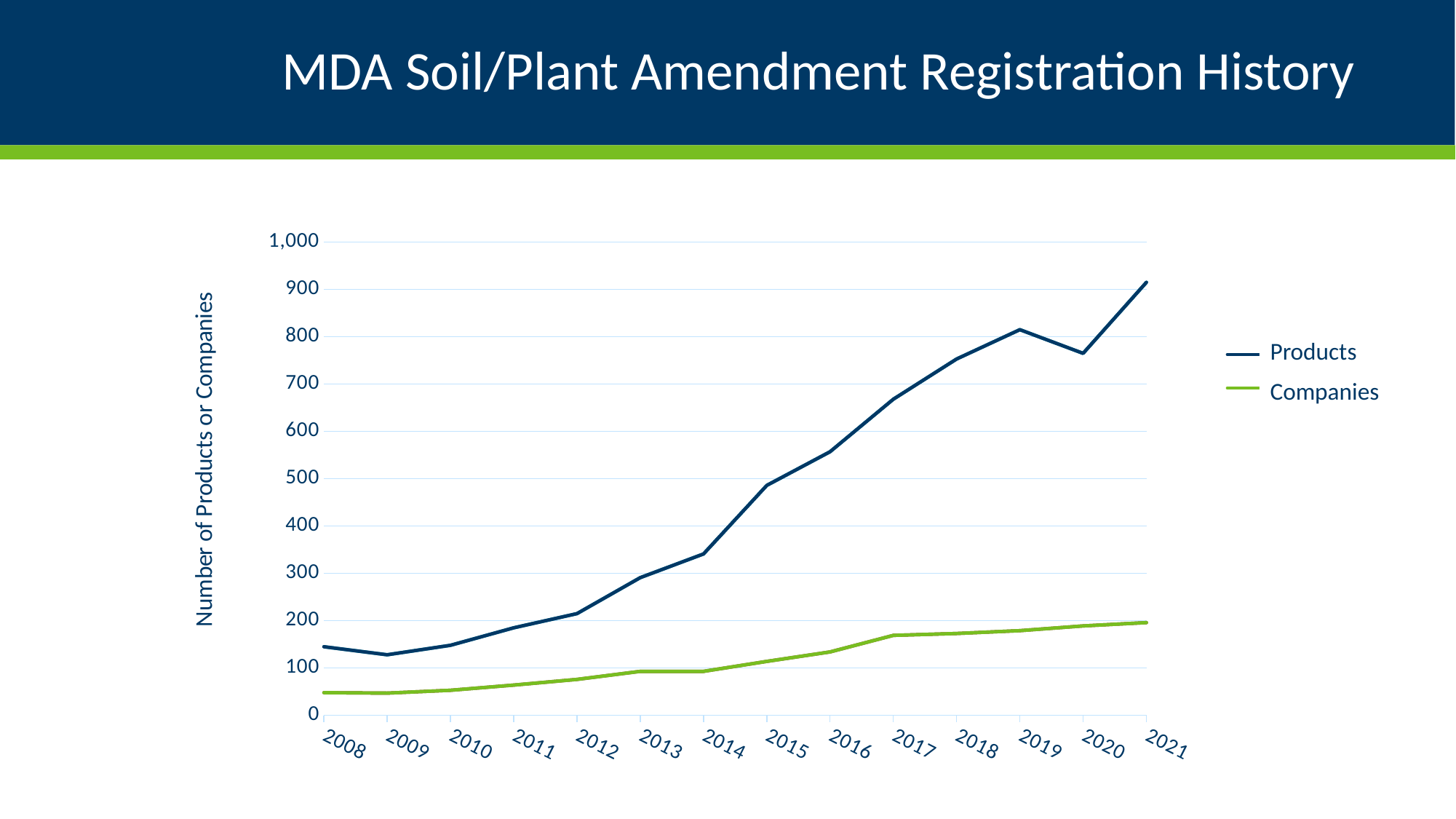
How many series does the legend list? 2 Is the Products value for 2014 greater or less than 400? less Does the Companies line generally rise or fall from 2008 to 2021? rise In which year is the Products value highest? 2021 Is the Companies value for 2021 greater or less than 100? greater What is the title of the vertical axis? Number of Products or Companies Is the Companies value for 2008 greater or less than 100? less How many years are plotted along the x axis? 14 Which year has the larger Products value, 2019 or 2020? 2019 In which year is the Products value lowest? 2009 What kind of chart is shown on the slide? line chart